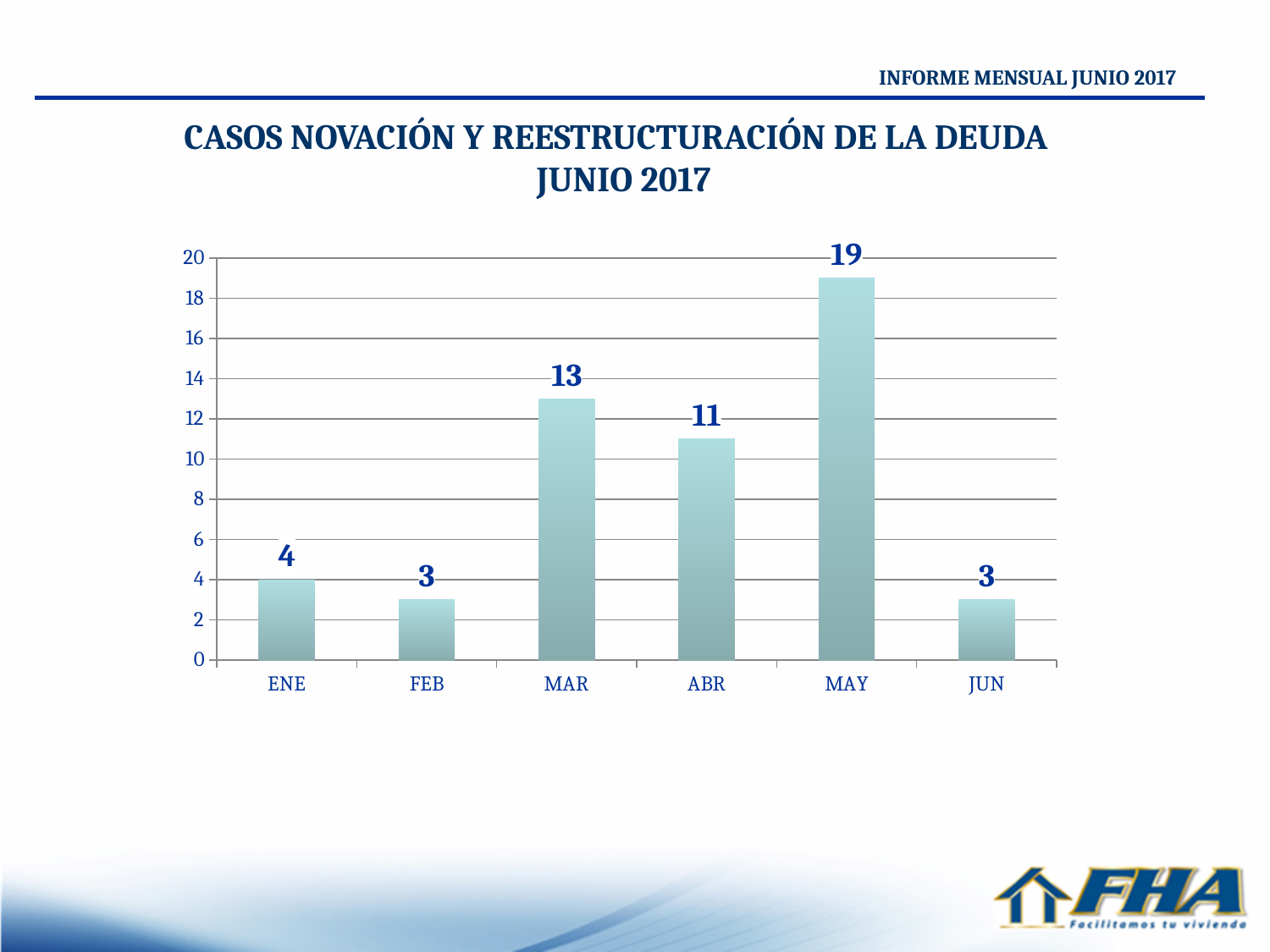
Which month has the highest value? MAY Which is larger, the value for MAR or the value for ABR? MAR What is the difference between the values for MAY and ABR? 8 What kind of chart is shown on the slide? bar chart What is the difference between the values for ENE and FEB? 1 Is the value for ABR greater or less than 10? greater Do the values rise or fall from ABR to MAY? rise What is the value for MAR? 13 What is the value for ENE? 4 What is the title of the chart? CASOS NOVACIÓN Y REESTRUCTURACIÓN DE LA DEUDA JUNIO 2017 What is the value for MAY? 19 How many months are shown on the x axis? 6